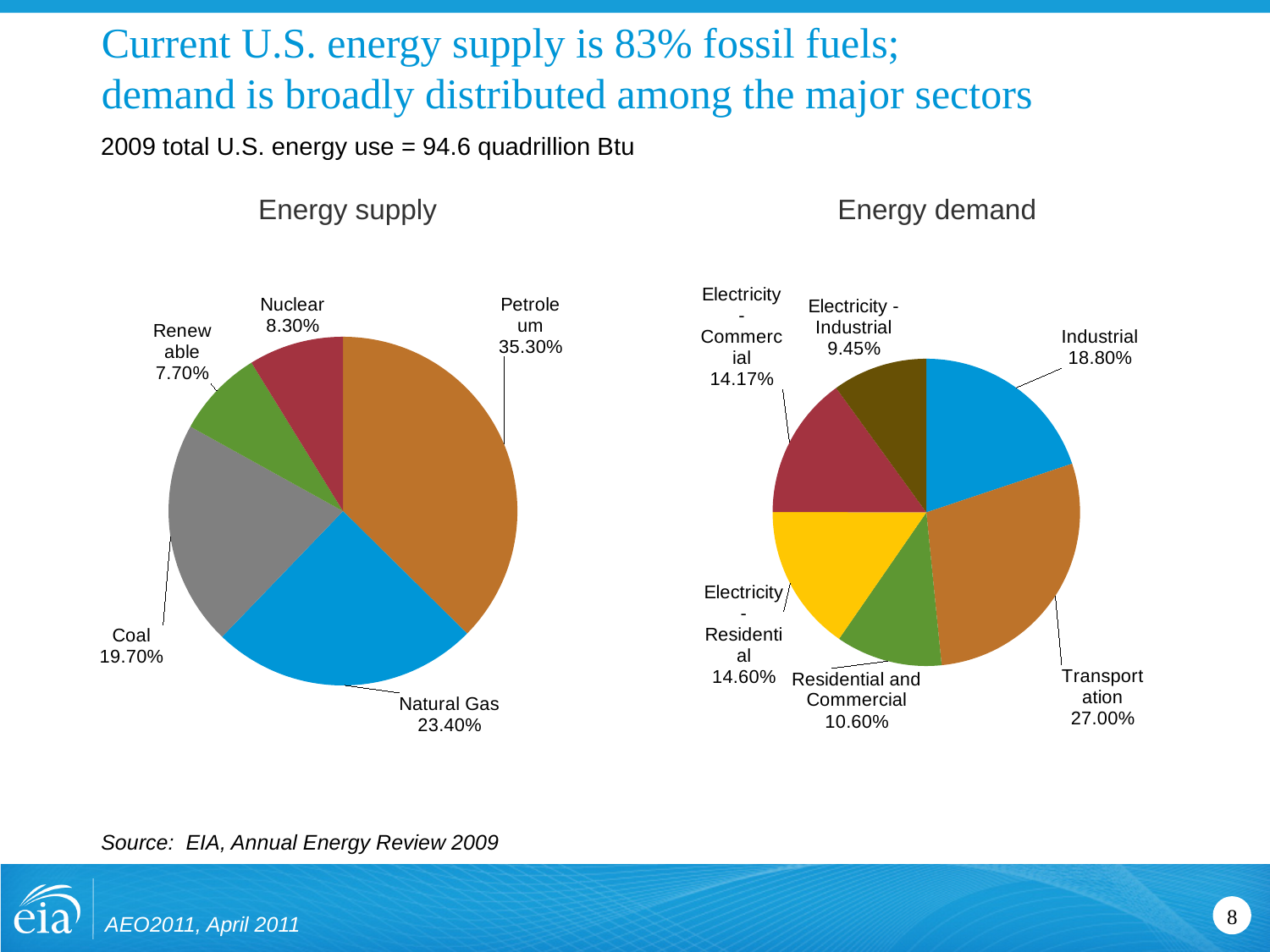
In the Energy demand chart, which category has the smallest share? Electricity - Industrial What type of chart is the Energy demand chart? Pie chart In the Energy demand chart, what share does Transportation have? 27.00% In the Energy supply chart, which category has the largest share? Petroleum In the Energy demand chart, what share does Electricity - Commercial have? 14.17% In the Energy supply chart, how many slices does the pie have? 5 In the Energy supply chart, what is the difference between the Natural Gas and Coal shares? 3.70% In the Energy supply chart, what share does Coal have? 19.70% In the Energy supply chart, what share does Petroleum have? 35.30% In the Energy demand chart, how many slices does the pie have? 6 In the Energy demand chart, which is larger, Industrial or Residential and Commercial? Industrial In the Energy supply chart, which category has the smallest share? Renewable